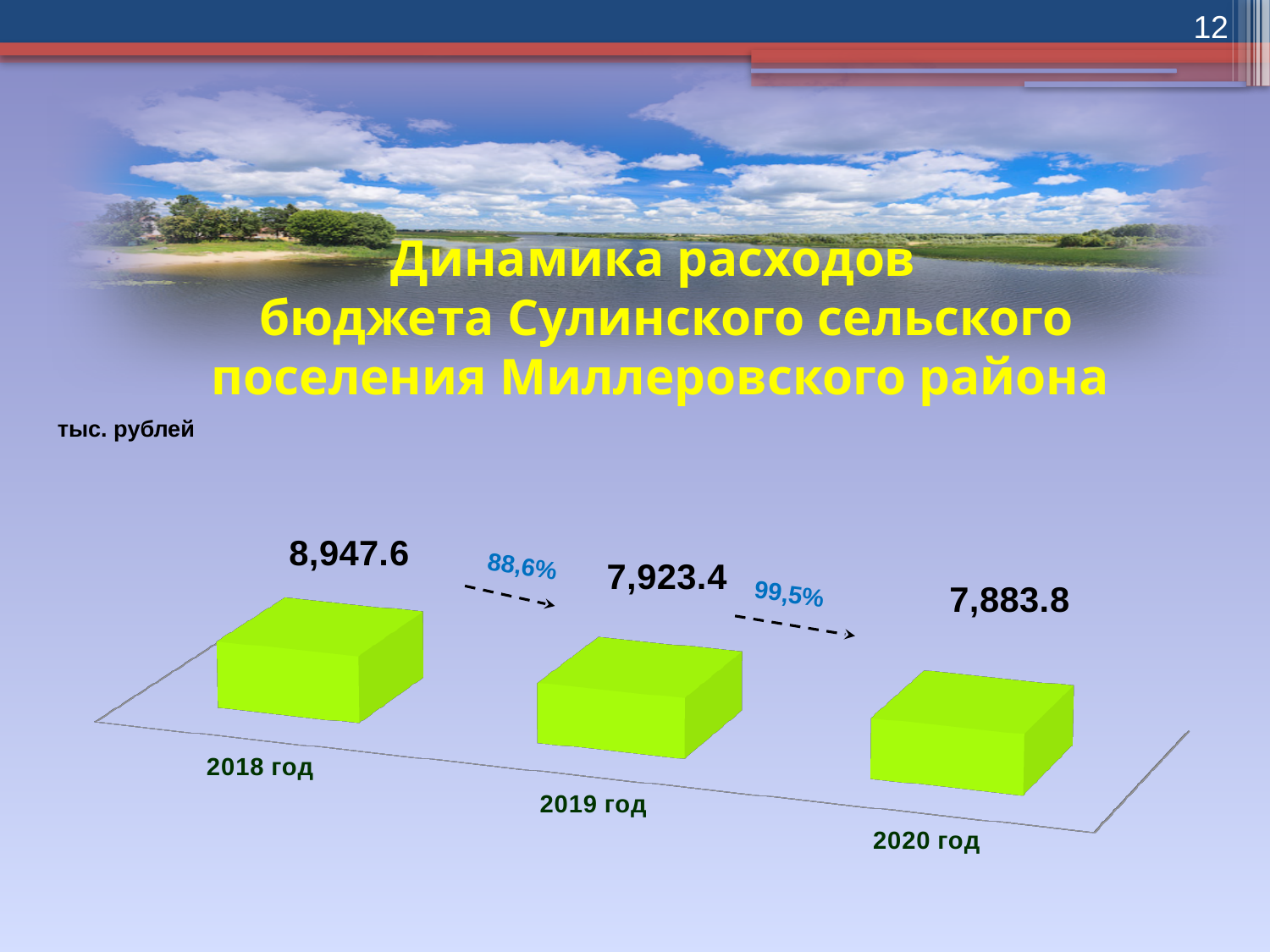
What is the budget expenditure value shown for 2020 год? 7,883.8 What is the difference between the 2018 год and 2019 год values? 1,024.2 Which is larger, the value for 2018 год or the value for 2020 год? 2018 год Which year has the lowest expenditure value on the chart? 2020 год What is the budget expenditure value shown for 2019 год? 7,923.4 What is the difference between the 2019 год and 2020 год values? 39.6 What is the budget expenditure value shown for 2018 год? 8,947.6 Which year has the highest expenditure value on the chart? 2018 год How many years (categories) are shown on the chart? 3 What unit of measurement is indicated for the chart values? тыс. рублей What kind of chart is shown on the slide? Bar chart Do the expenditure values rise or fall from 2018 год to 2020 год? Fall